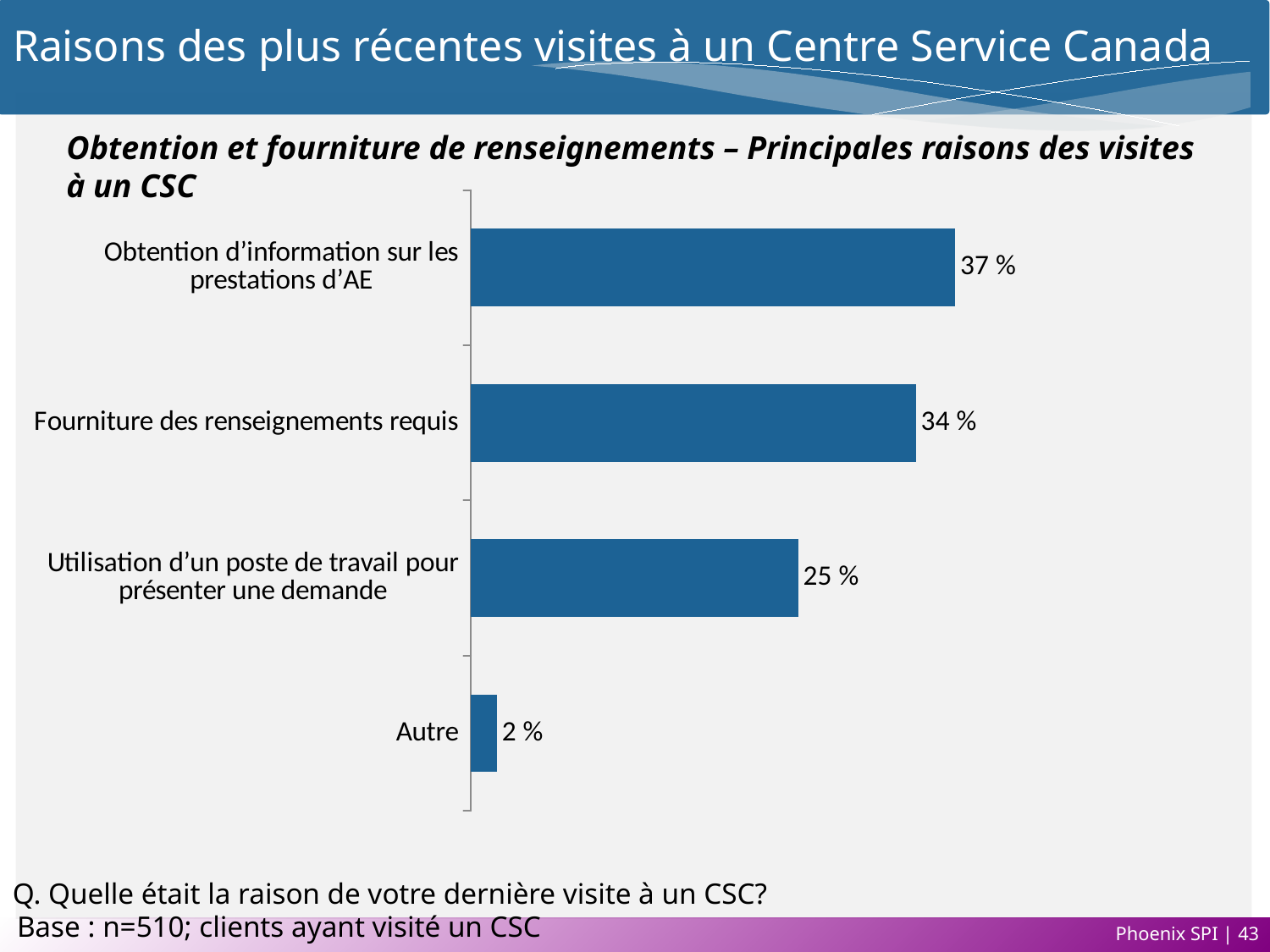
What is the base (sample size) stated for the chart? n=510 What kind of chart is shown on the slide? Bar chart What is the value for "Autre"? 2 % How many categories are shown in the chart? 4 What is the value for "Obtention d’information sur les prestations d’AE"? 37 % What is the value for "Fourniture des renseignements requis"? 34 % What is the difference between the values for "Obtention d’information sur les prestations d’AE" and "Fourniture des renseignements requis"? 3 % What is the value for "Utilisation d’un poste de travail pour présenter une demande"? 25 % Which category has the lowest value? Autre Which is larger: the value for "Utilisation d’un poste de travail pour présenter une demande" or the value for "Autre"? Utilisation d’un poste de travail pour présenter une demande Which category has the highest value? Obtention d’information sur les prestations d’AE What is the difference between the values for "Fourniture des renseignements requis" and "Utilisation d’un poste de travail pour présenter une demande"? 9 %